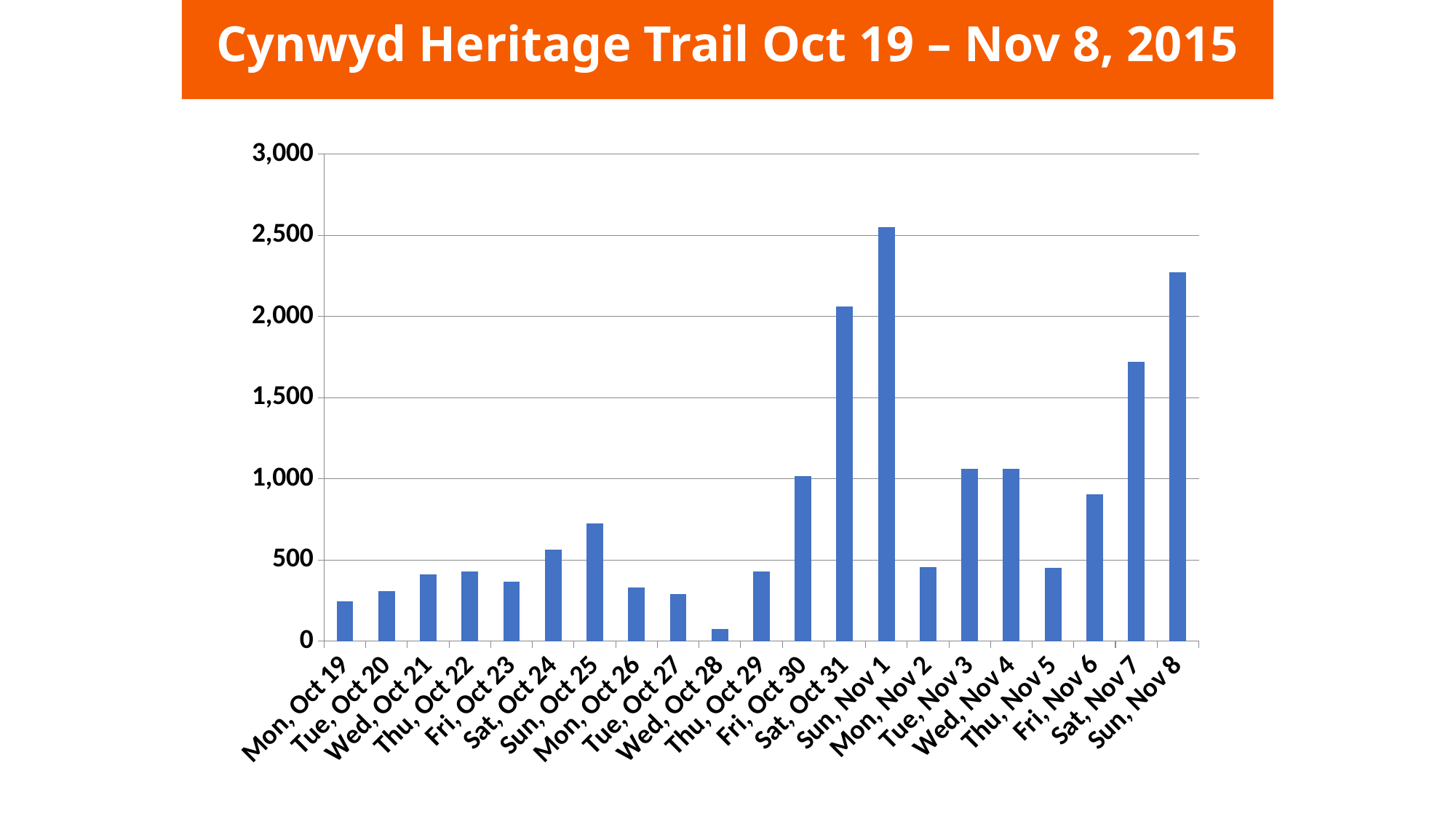
Which day has the lowest value? Wed, Oct 28 Is the value for Fri, Nov 6 greater or less than 1,000? less How many days (categories) are plotted on the x axis? 21 Is the value for Sat, Nov 7 greater or less than 1,500? greater Which is larger, the value for Sat, Oct 24 or the value for Sun, Oct 25? Sun, Oct 25 Which is larger, the value for Sat, Nov 7 or the value for Sun, Nov 8? Sun, Nov 8 What kind of chart is shown on the slide? bar chart What is the title of the chart? Cynwyd Heritage Trail Oct 19 – Nov 8, 2015 Is the value for Sun, Nov 8 greater or less than 2,000? greater Which day has the highest value? Sun, Nov 1